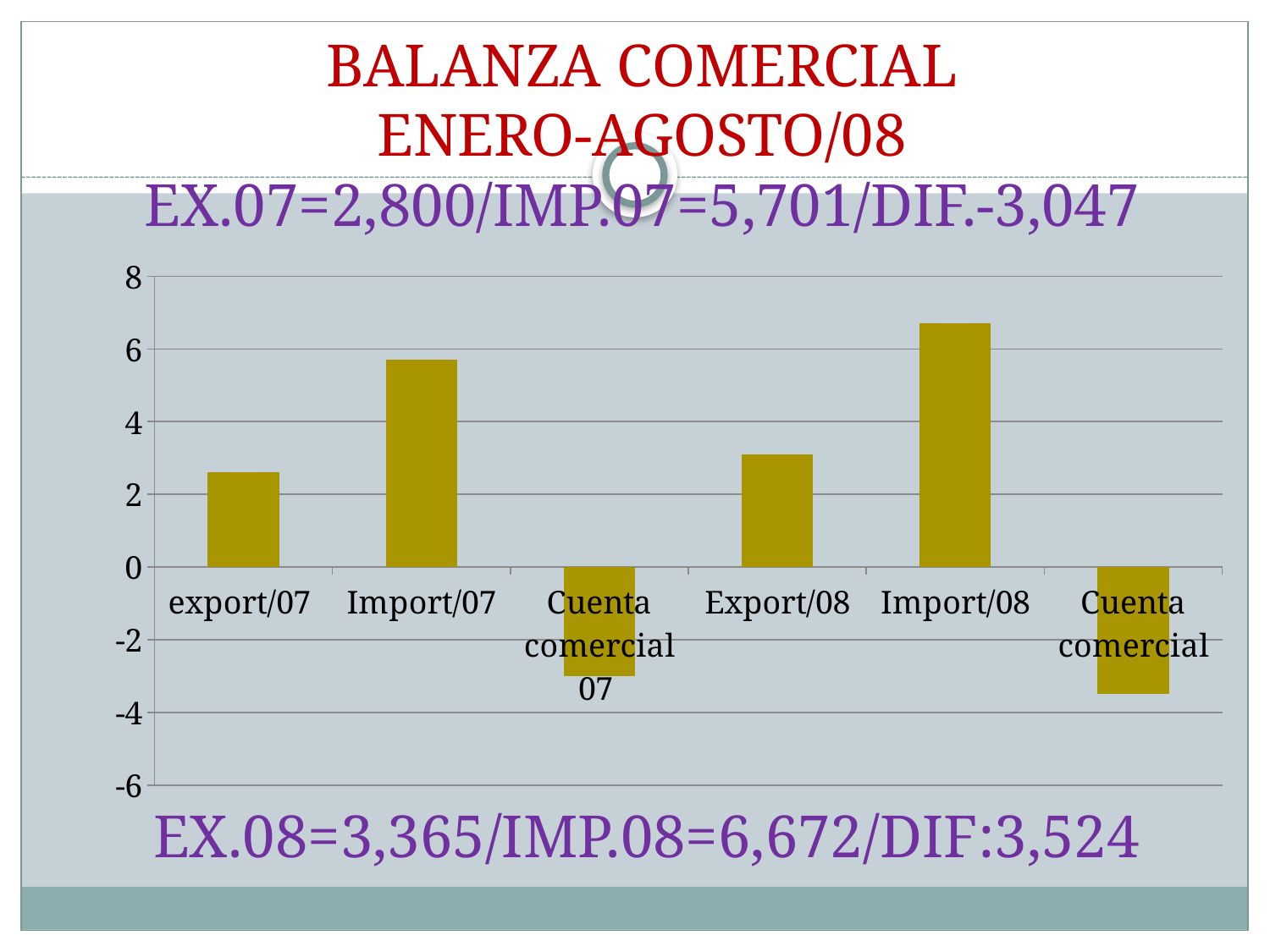
Which category has the highest bar in the chart? Import/08 Is the value for export/07 greater or less than 2? greater What kind of chart is shown on the slide? bar chart Which is larger, the value for Export/08 or the value for export/07? Export/08 Which category has the lowest bar in the chart? Cuenta comercial (the last category, for 08) Is the value for Cuenta comercial 07 greater or less than -2? less Is the value for Import/08 greater or less than 6? greater What is the highest tick value shown on the vertical axis of the chart? 8 What is the title shown at the top of the slide? BALANZA COMERCIAL ENERO-AGOSTO/08 How many categories are plotted on the x axis of the chart? 6 Which is larger, the value for Import/07 or the value for Export/08? Import/07